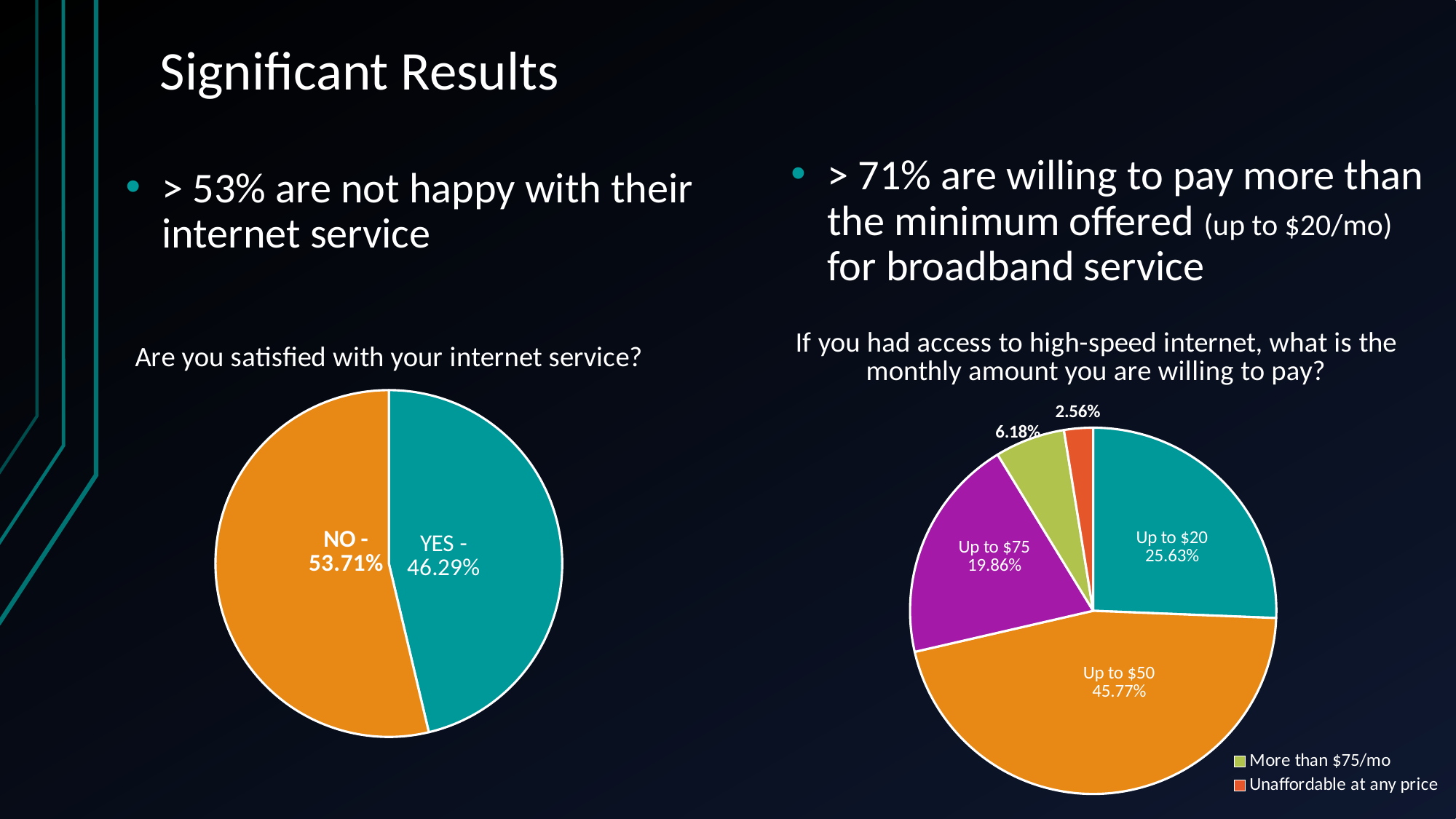
In the monthly amount willing to pay chart, which category has the largest share? Up to $50 In the monthly amount willing to pay chart, what share chose 'Up to $75'? 19.86% In the 'Are you satisfied with your internet service?' chart, which answer has the larger share? NO In the monthly amount willing to pay chart, which category has the smallest share? Unaffordable at any price In the monthly amount willing to pay chart, what share chose 'Up to $20'? 25.63% In the 'Are you satisfied with your internet service?' chart, what percentage answered YES? 46.29% How many slices does the monthly amount willing to pay pie chart have? 5 In the 'Are you satisfied with your internet service?' chart, what percentage answered NO? 53.71% What kind of chart is the 'Are you satisfied with your internet service?' chart? Pie chart In the monthly amount willing to pay chart, what share chose 'Up to $50'? 45.77% In the monthly amount willing to pay chart, what is the difference between the 'Up to $50' and 'Up to $20' shares? 20.14% In the 'Are you satisfied with your internet service?' chart, what is the difference between the NO and YES shares? 7.42%